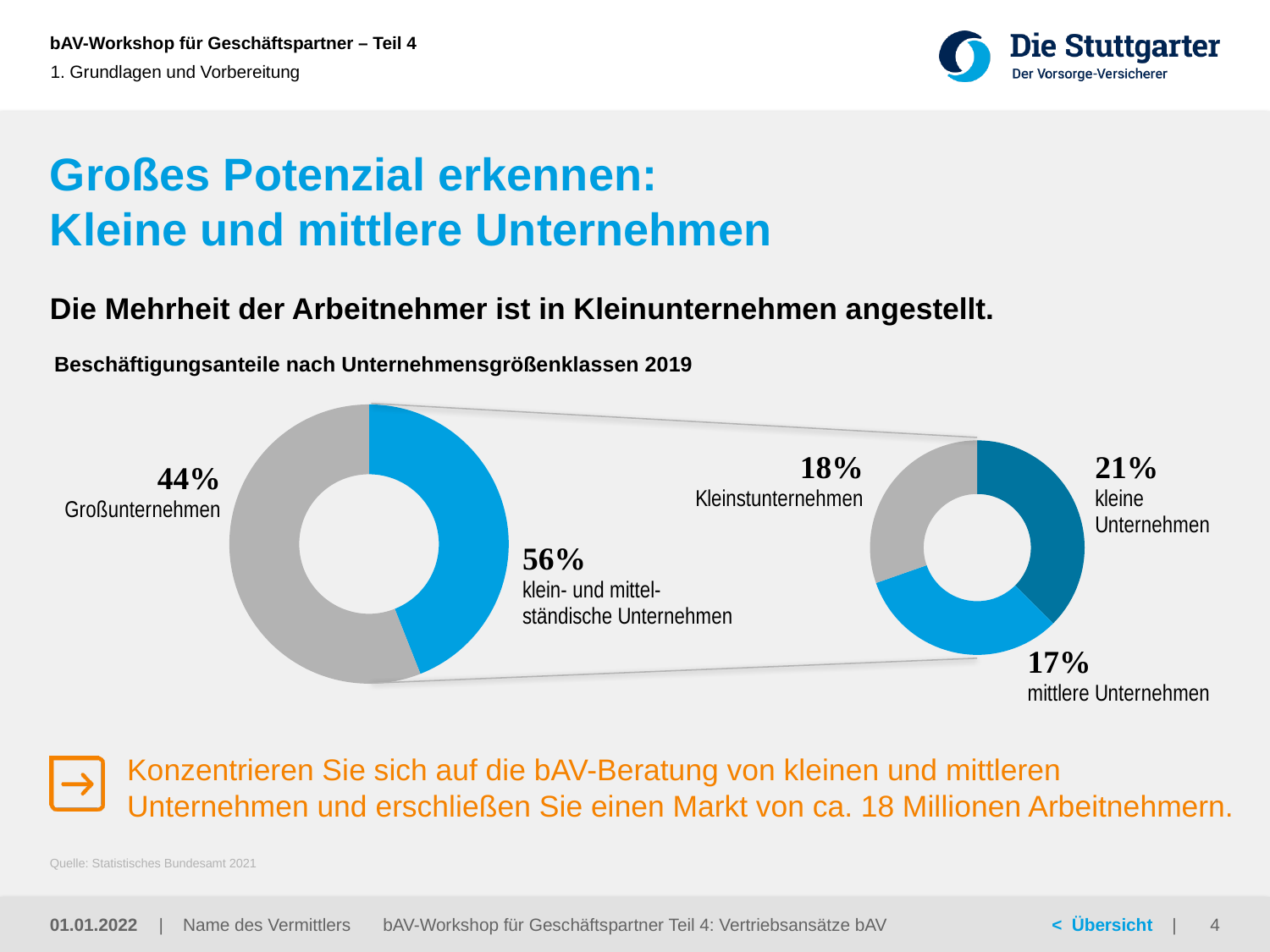
On the right donut chart, what share is shown for mittlere Unternehmen? 17% On the right donut chart, which category has the smallest share? mittlere Unternehmen What is the title given above the charts? Beschäftigungsanteile nach Unternehmensgrößenklassen 2019 What type of chart is used on this slide? Donut (pie) chart On the right donut chart, which category has the largest share? kleine Unternehmen On the right donut chart, what share is shown for kleine Unternehmen? 21% On the left donut chart, what share is shown for klein- und mittelständische Unternehmen? 56% On the right donut chart, what share is shown for Kleinstunternehmen? 18% On the right donut chart, which is larger: the share for Kleinstunternehmen or for mittlere Unternehmen? Kleinstunternehmen How many segments does the right donut chart have? 3 On the left donut chart, what is the difference in percentage points between klein- und mittelständische Unternehmen and Großunternehmen? 12 On the left donut chart, what share is shown for Großunternehmen? 44%